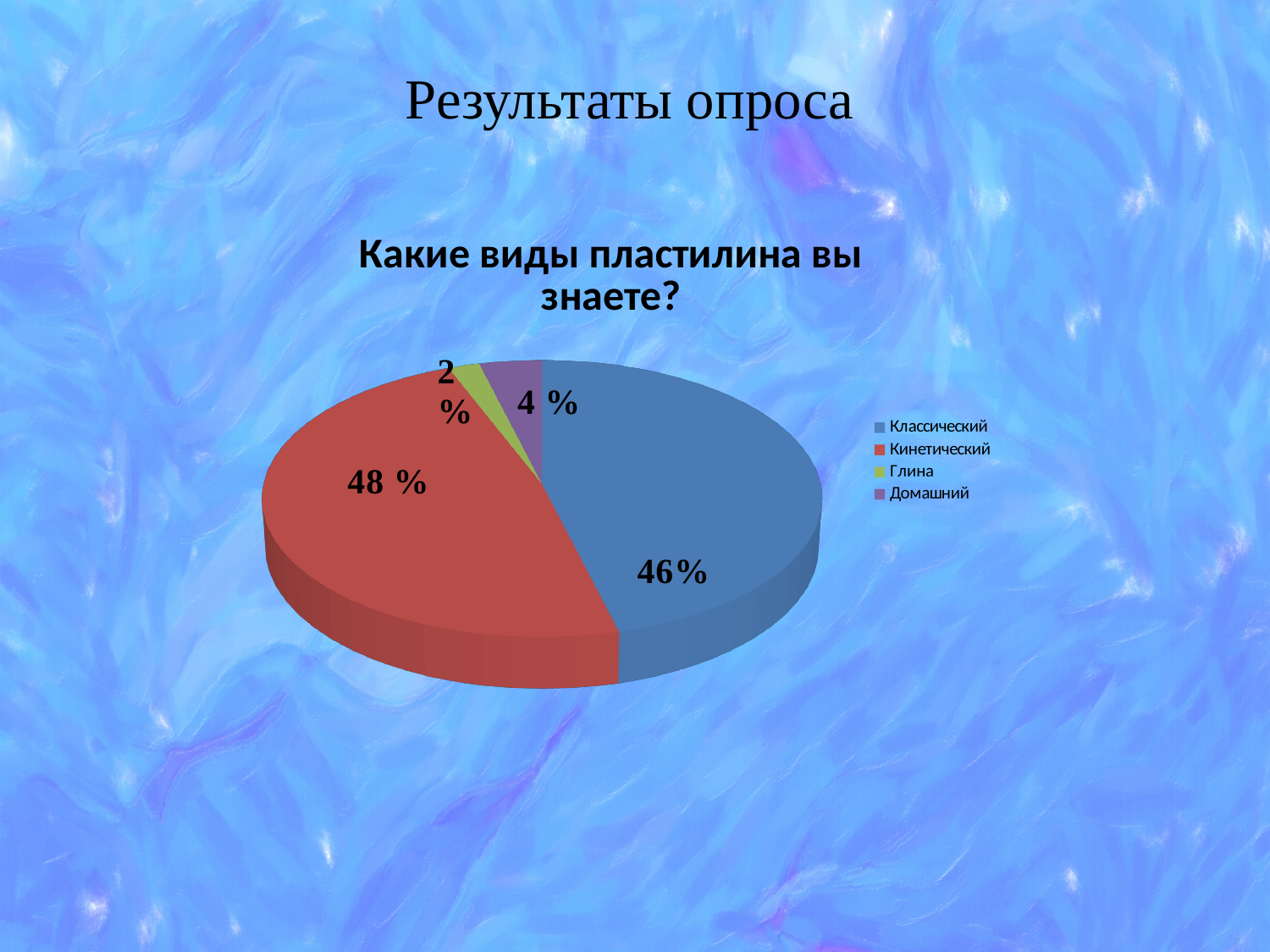
How many categories does the pie chart have? 4 Which colour represents Глина in the legend? green What share of the pie does Кинетический have? 48 % What share of the pie does Классический have? 46% Which is larger, the share for Домашний or the share for Глина? Домашний What kind of chart is shown on the slide? pie chart Which category has the largest slice of the pie? Кинетический What share of the pie does Глина have? 2 % Which category has the smallest slice of the pie? Глина By how many percentage points does Кинетический exceed Классический? 2 What is the chart's title? Какие виды пластилина вы знаете?